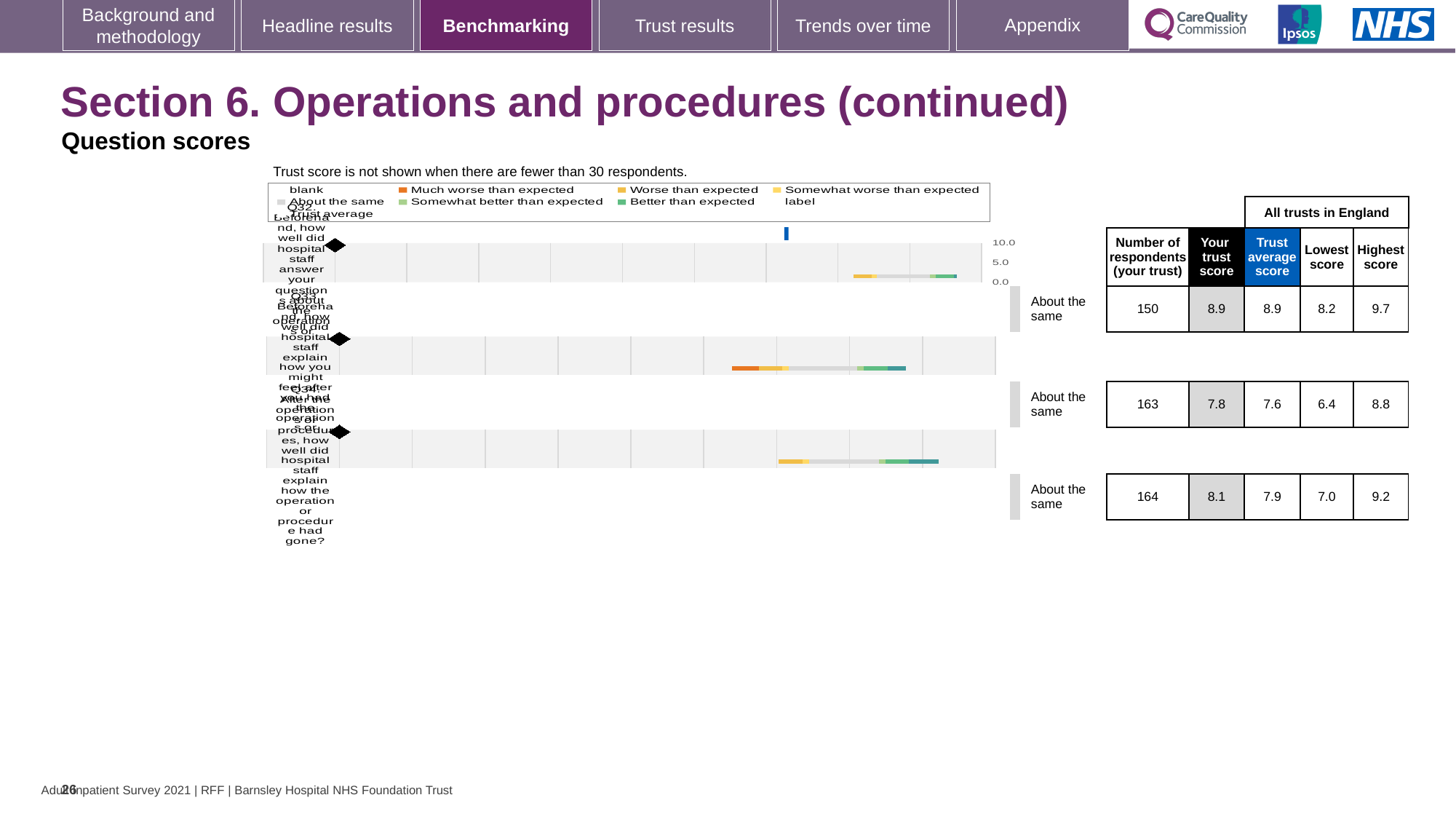
What is the total number of respondents across the three rows of the table? 477 In the third row of the table, how much higher is 'Your trust score' than 'Trust average score'? 0.2 In the table, what is the 'Highest score' value in the third row? 9.2 In the second row of the table, which is larger: 'Your trust score' or 'Trust average score'? Your trust score How many question rows are shown in the chart and table? 3 What is the smallest 'Lowest score' value shown in the table? 6.4 In the first row of the table, what is the difference between the highest score and the lowest score? 1.5 What benchmark category label is shown next to each of the three questions? About the same In the table, what is the 'Your trust score' value in the second row? 7.8 In the table, what is the 'Trust average score' in the first row? 8.9 In the table, how many respondents (your trust) are shown in the first row? 150 Which row of the table has the highest 'Your trust score', and what is it? First row, 8.9